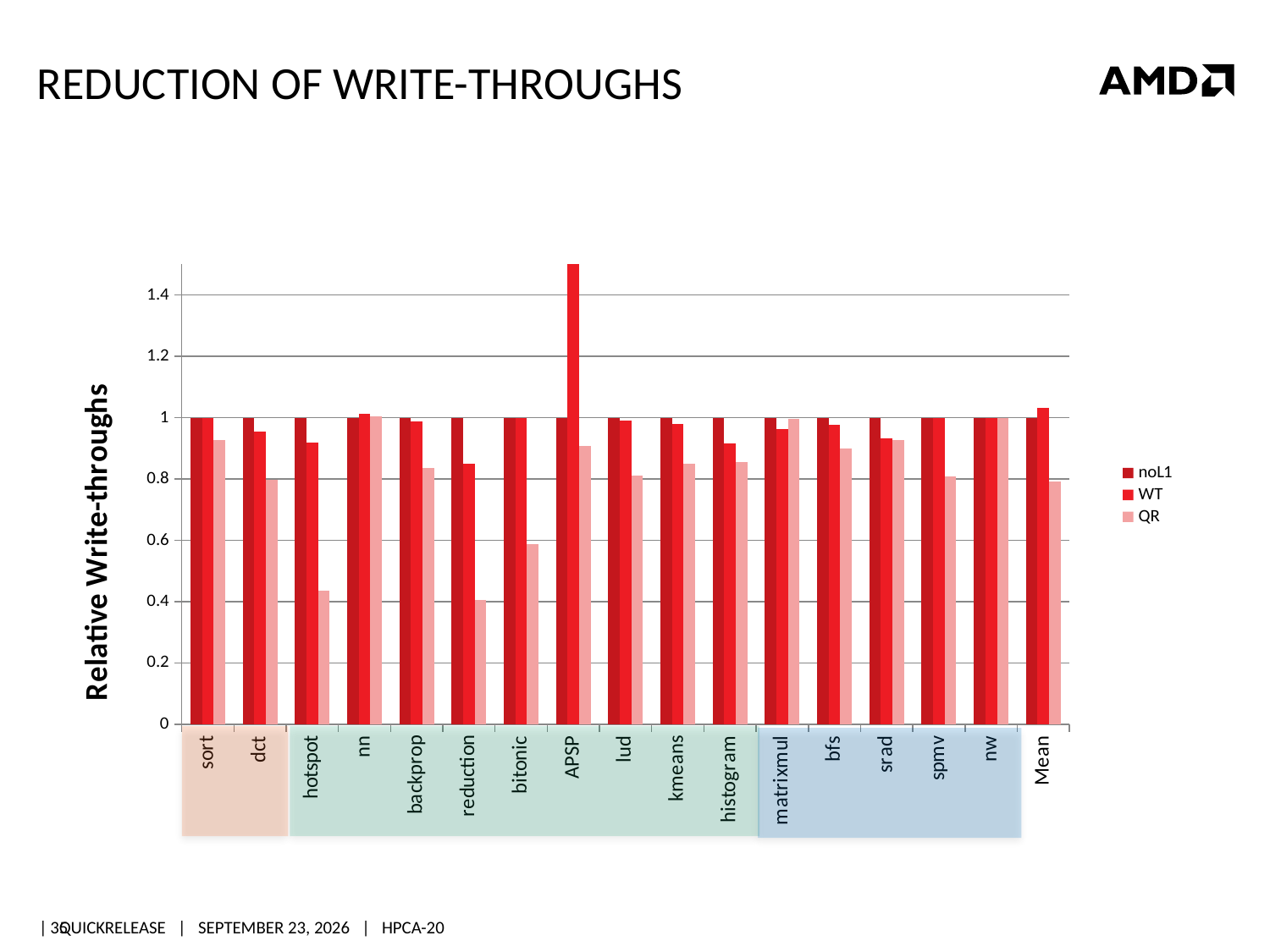
What kind of chart is shown on the slide? bar chart How many categories are shown along the x axis? 17 Is the QR value for reduction greater or less than 0.6? less Which category has the highest WT value? APSP What is the noL1 value for sort? 1 Is the WT value for APSP greater or less than 1.4? greater Is the QR value for bitonic greater or less than 0.8? less What is the title of the y axis? Relative Write-throughs How many series does the legend list? 3 Which is larger, the QR value for sort or the QR value for hotspot? sort What are the three series named in the legend? noL1, WT, QR